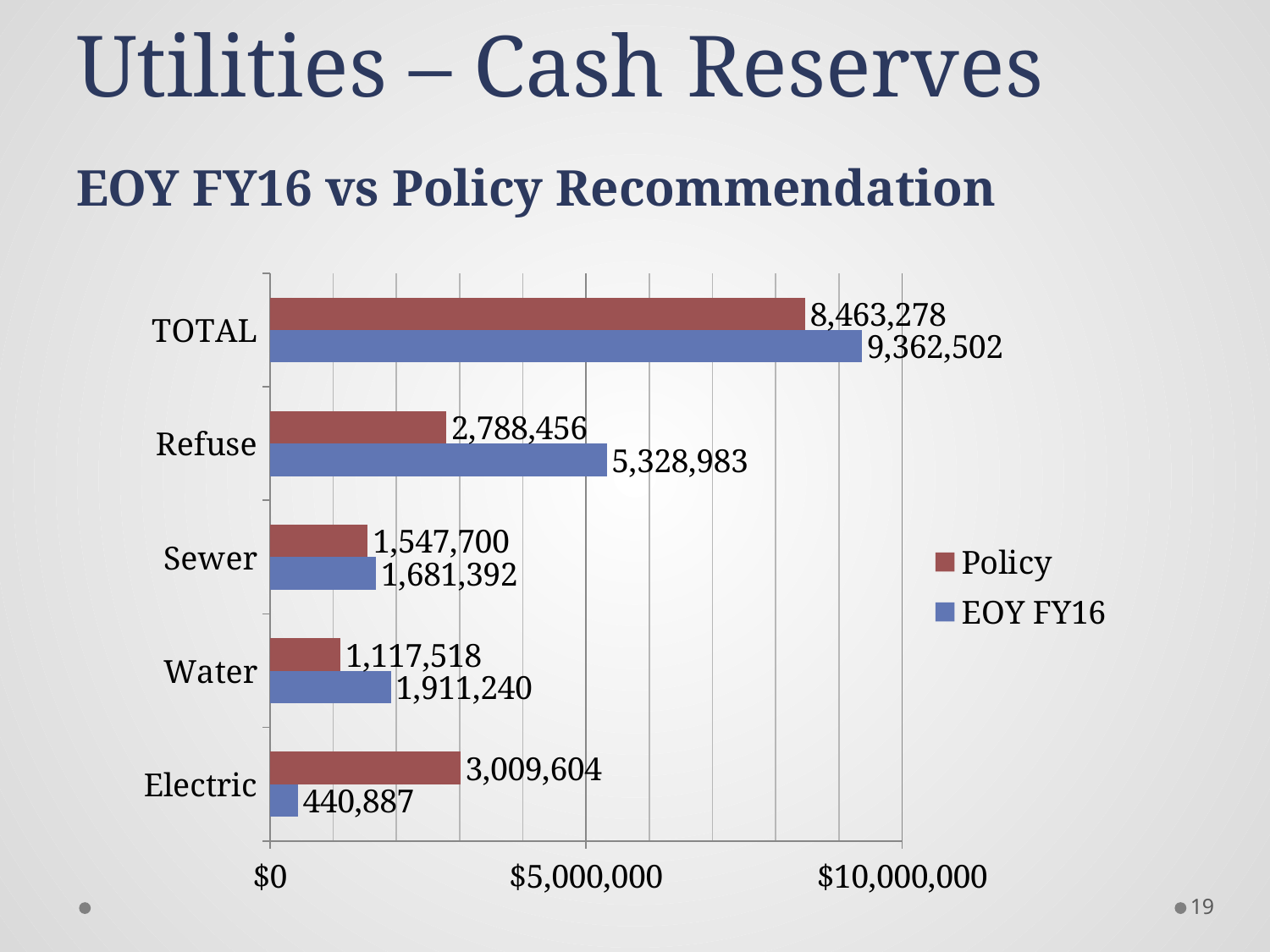
Excluding TOTAL, which category has the highest Policy value? Electric What is the EOY FY16 value for Refuse? 5,328,983 How many series does the legend list? 2 What is the EOY FY16 value for TOTAL? 9,362,502 What is the Policy value for Water? 1,117,518 How many categories are shown on the chart? 5 Which category has the lowest EOY FY16 value? Electric What is the Policy value for Electric? 3,009,604 What is the difference between the Policy and EOY FY16 values for Electric? 2,568,717 What is the difference between the EOY FY16 and Policy values for Refuse? 2,540,527 For Sewer, which is larger: the Policy value or the EOY FY16 value? EOY FY16 Is the EOY FY16 value for Refuse greater or less than $5,000,000? greater